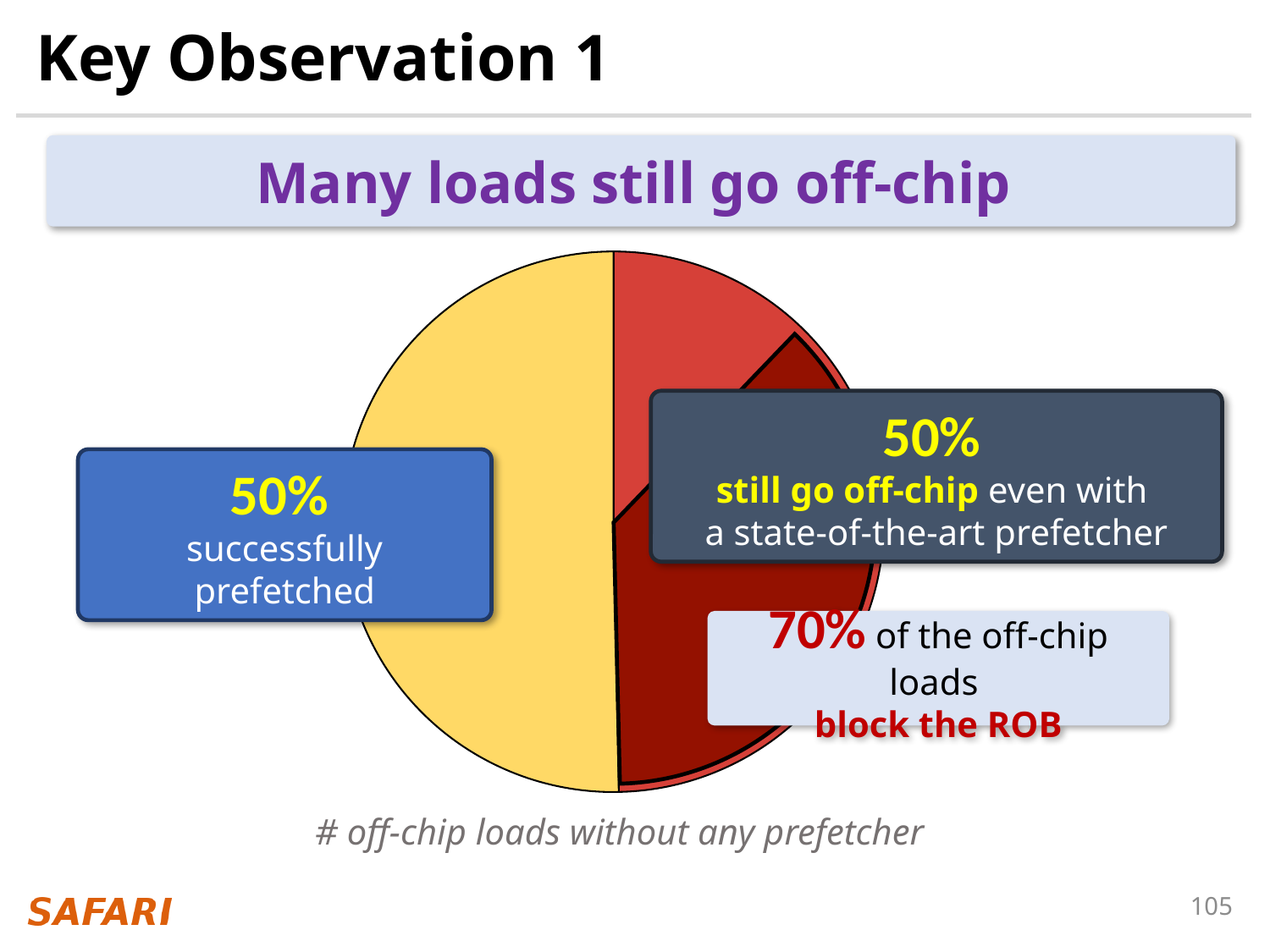
What kind of chart is shown on the slide? pie chart What is the difference between the share of loads successfully prefetched and the share that still go off-chip? 0% What share of off-chip loads without any prefetcher are successfully prefetched according to the pie chart? 50% Is the share of off-chip loads that block the ROB greater or less than 50%? greater What percentage of the off-chip loads block the ROB according to the slide? 70% Is the share of loads that are successfully prefetched larger or smaller than the share that still go off-chip? equal What is the combined share of loads successfully prefetched and loads that still go off-chip? 100% What share of loads still go off-chip even with a state-of-the-art prefetcher according to the pie chart? 50% Which colour represents the loads that are successfully prefetched in the pie chart? yellow What does the caption below the pie chart say the chart represents? # off-chip loads without any prefetcher